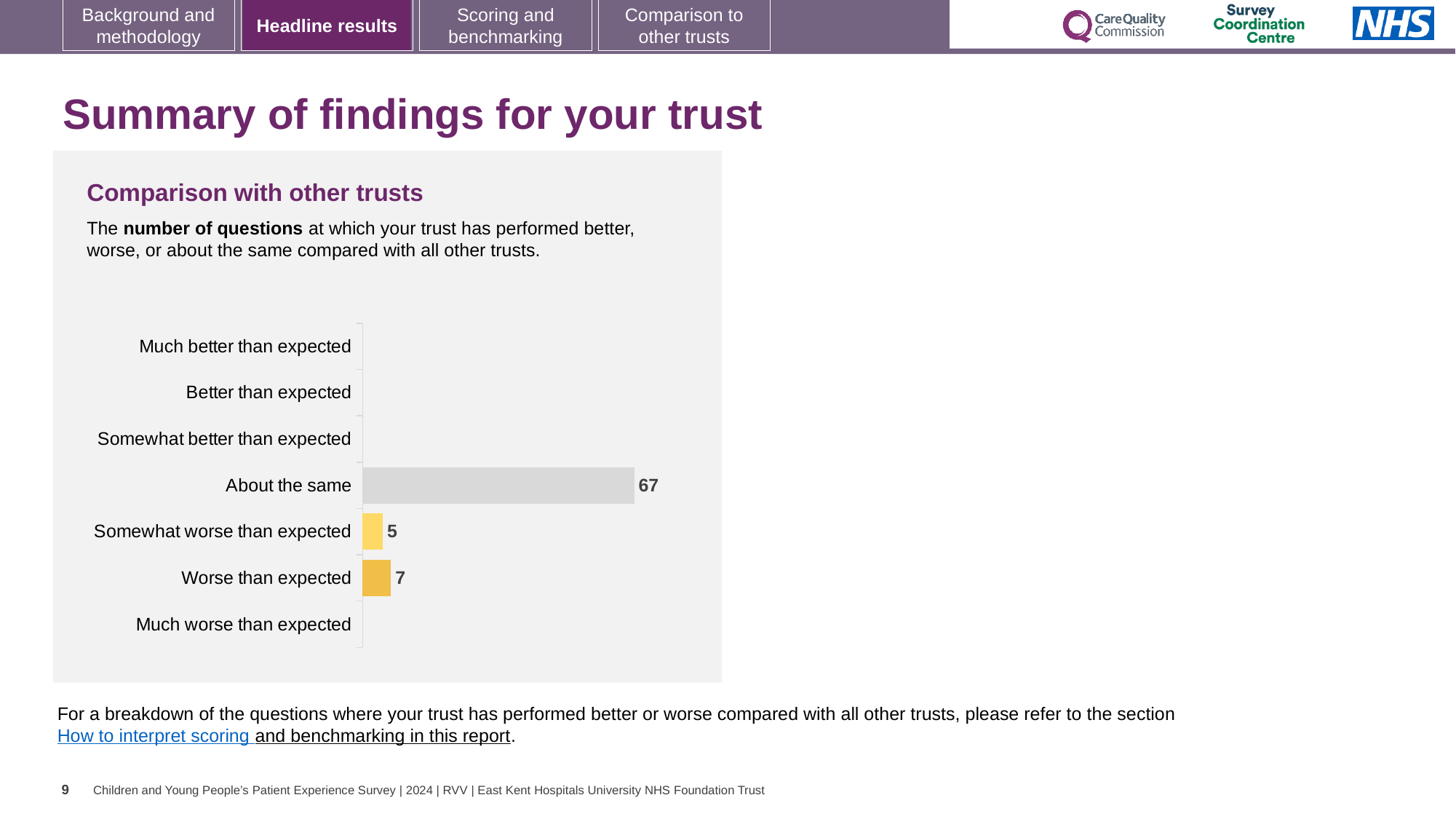
Which category has the highest number of questions? About the same What is the total number of questions across 'Somewhat worse than expected' and 'Worse than expected'? 12 What is the difference between the number of questions 'About the same' and 'Worse than expected'? 60 What is the value for 'Somewhat worse than expected'? 5 How many questions did the trust perform 'About the same' on compared with other trusts? 67 How many categories are listed on the chart's vertical axis? 7 Which is larger: 'Worse than expected' or 'Somewhat worse than expected'? Worse than expected What is the value for 'Worse than expected'? 7 What is the title of the chart section? Comparison with other trusts What is the difference between 'Worse than expected' and 'Somewhat worse than expected'? 2 What kind of chart is shown on the slide? Bar chart How many categories have a visible bar with a value? 3